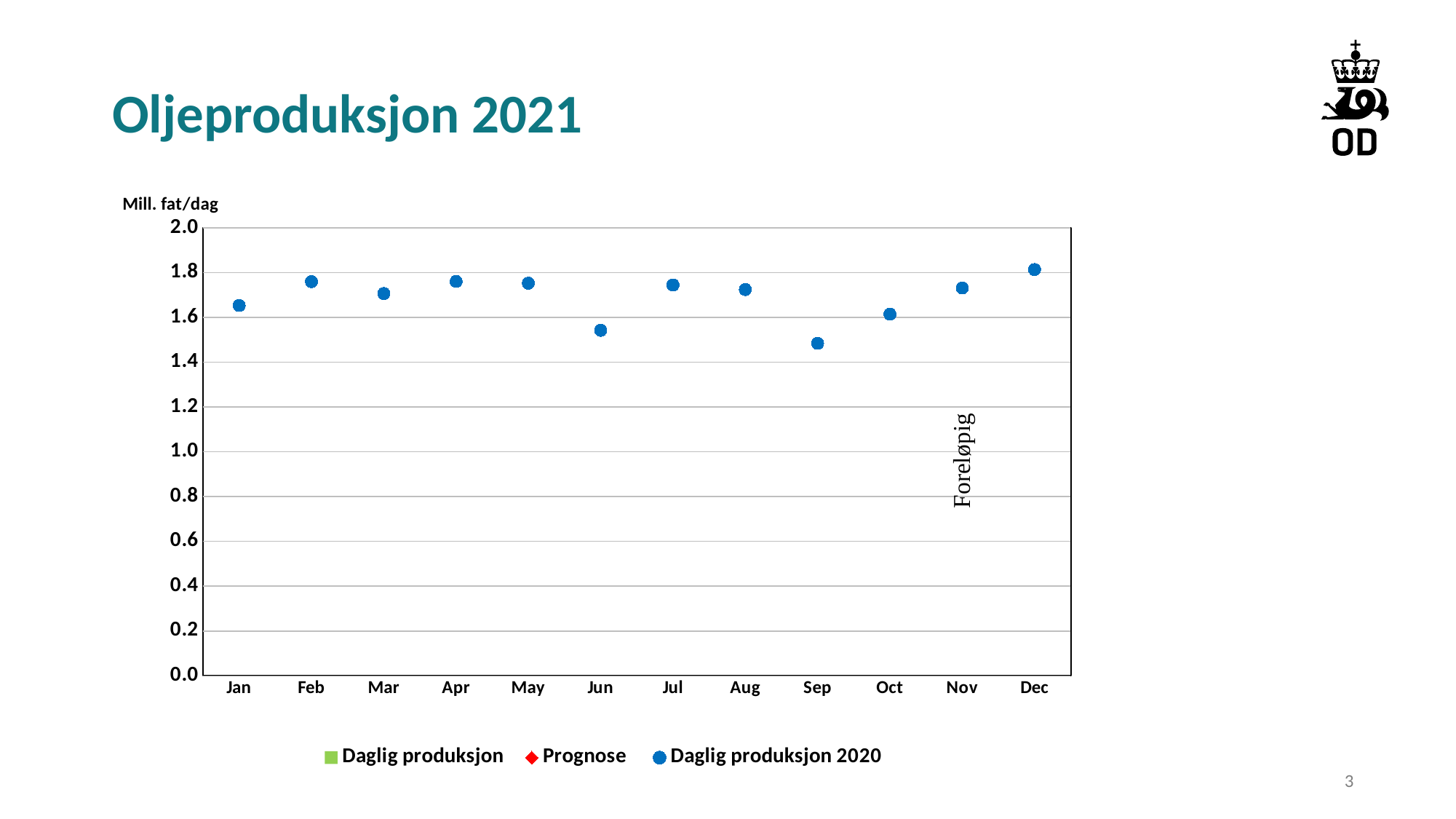
How many months are shown on the x axis of the chart? 12 How many series does the chart legend list? 3 Is the value for Daglig produksjon 2020 in Sep greater or less than 1.6? less What kind of chart is shown on the slide? Scatter (dot) chart Which month has the lowest value for Daglig produksjon 2020? Sep Which month has the highest value for Daglig produksjon 2020? Dec Which is larger for Daglig produksjon 2020, Jun or Sep? Jun Is the value for Daglig produksjon 2020 in Jun greater or less than 1.6? less What is the title of the slide's chart? Oljeproduksjon 2021 Which is larger for Daglig produksjon 2020, Jan or Feb? Feb Is the value for Daglig produksjon 2020 in Feb greater or less than 1.6? greater What unit is shown on the y axis of the chart? Mill. fat/dag